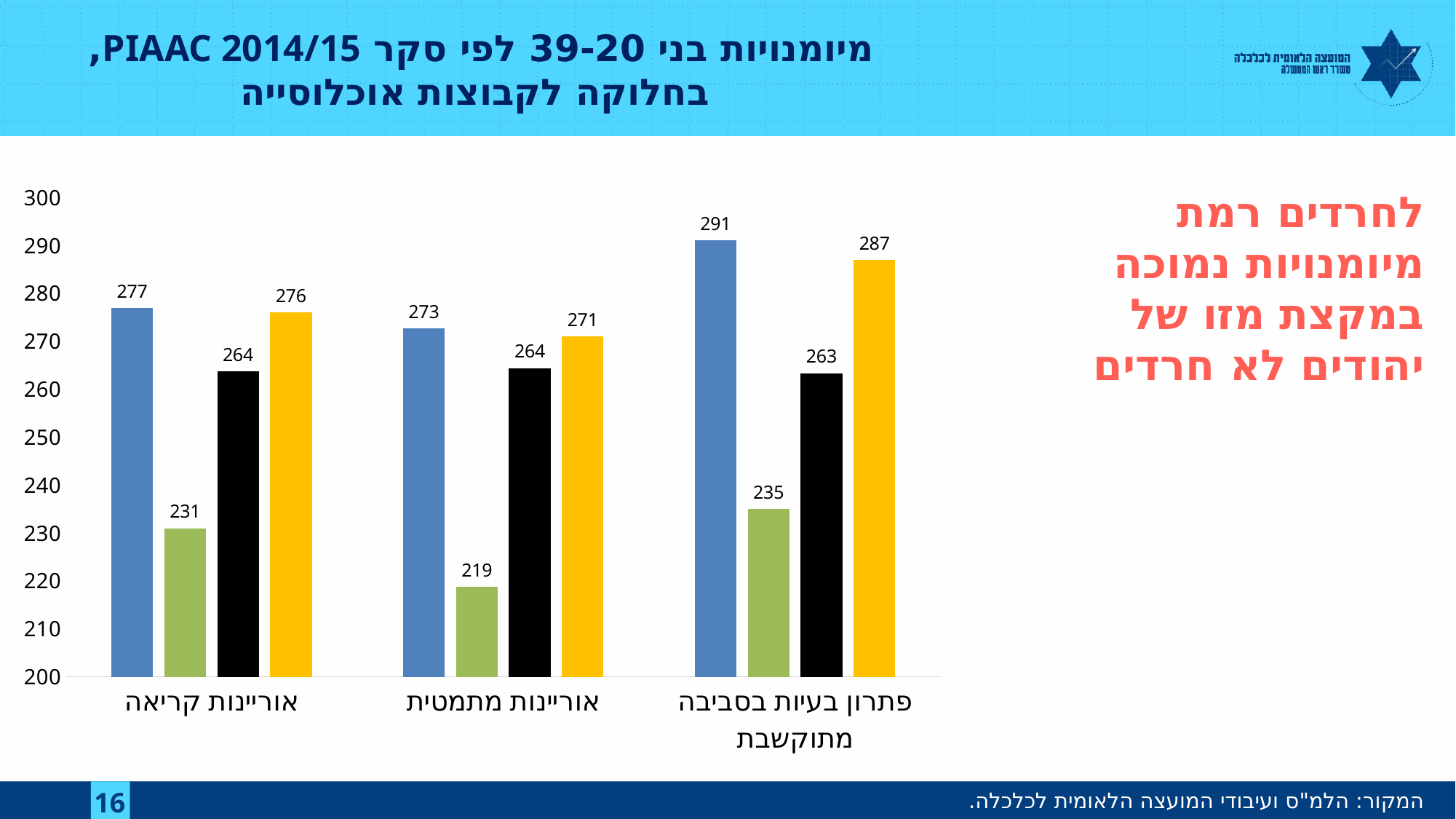
How many categories are shown on the x axis of the chart? 3 What is the value of the blue bar for אוריינות קריאה? 277 Which category has the lowest green bar? אוריינות מתמטית Which category has the highest blue bar? פתרון בעיות בסביבה מתוקשבת What is the value of the yellow bar for פתרון בעיות בסביבה מתוקשבת? 287 What is the difference between the blue bar and the green bar for פתרון בעיות בסביבה מתוקשבת? 56 What is the value of the green bar for אוריינות מתמטית? 219 Which is larger for אוריינות קריאה: the black bar or the yellow bar? the yellow bar What colour is the bar with the lowest value in each category? green What is the value of the black bar for אוריינות מתמטית? 264 Is the green bar for אוריינות קריאה greater or less than 240? less What kind of chart is shown on the slide? bar chart